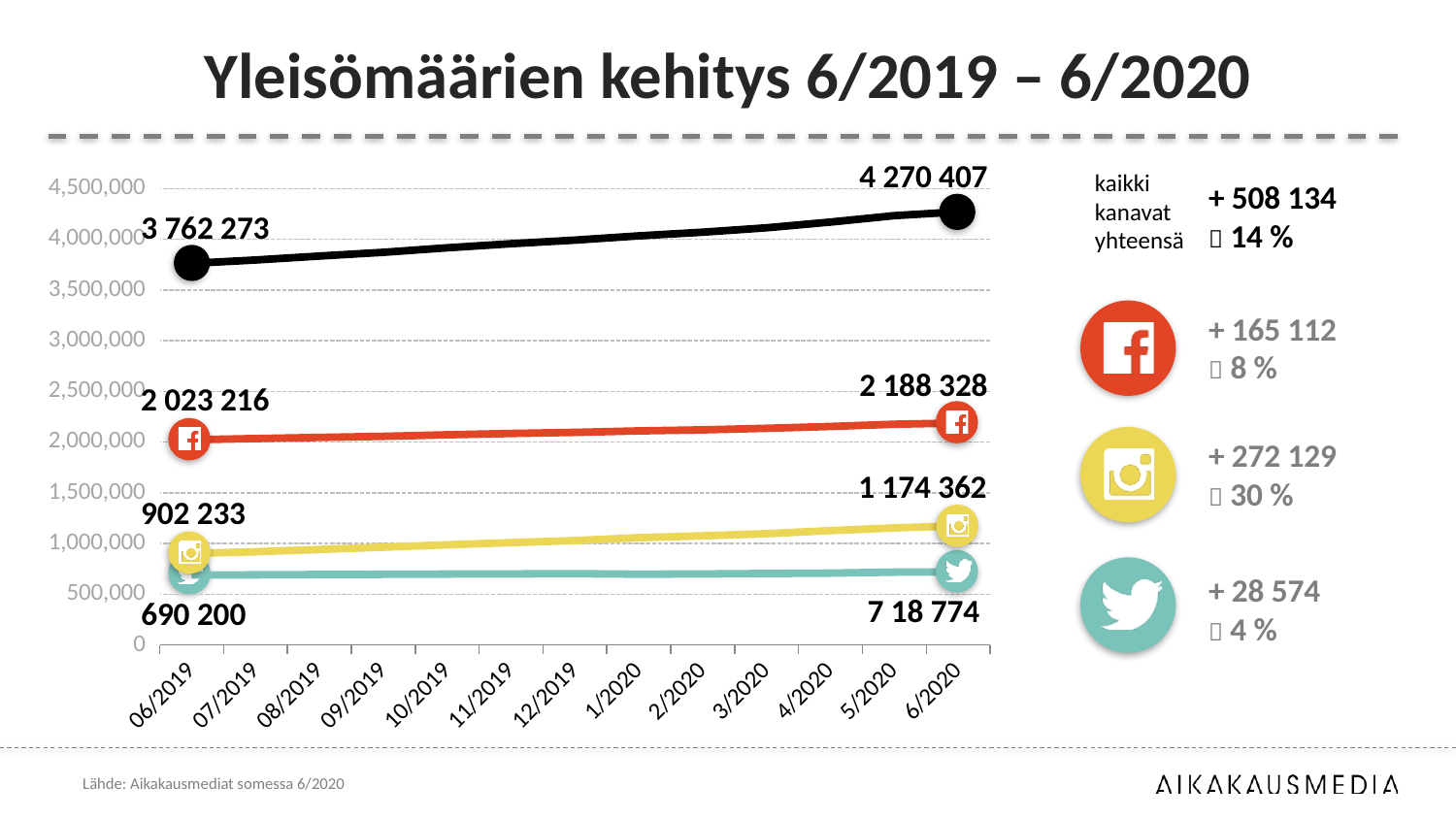
What is the value of the red Facebook line at 6/2020? 2 188 328 What kind of chart is shown on the slide? line chart By how much did the red Facebook line increase from 06/2019 to 6/2020? 165 112 Which line has the lowest value at 06/2019? the teal Twitter line What is the value of the yellow Instagram line at 06/2019? 902 233 What is the value of the black (total) line at 06/2019? 3 762 273 At 6/2020, which is larger: the yellow Instagram line or the teal Twitter line? the yellow Instagram line What is the value of the yellow Instagram line at 6/2020? 1 174 362 Which line has the highest value at 6/2020? the black (total) line What is the value of the black (total) line at 6/2020? 4 270 407 Is the value of the teal Twitter line at 6/2020 greater or less than 500,000? greater By how much did the black (total) line increase from 06/2019 to 6/2020? 508 134